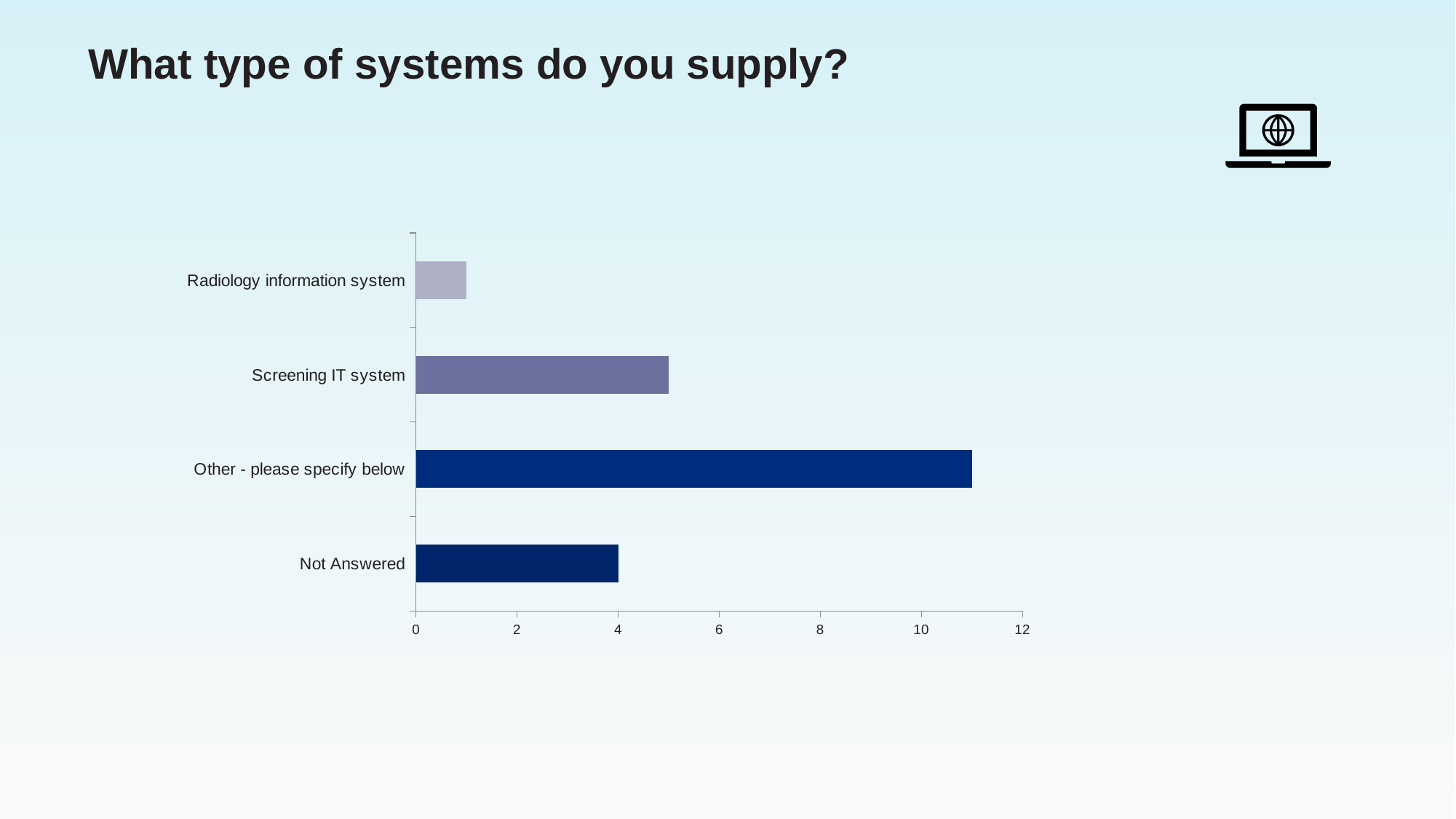
Which is larger, the value for Not Answered or the value for Radiology information system? Not Answered What type of chart is shown on the slide? bar chart Which category has the highest value? Other - please specify below Which is larger, the value for Other - please specify below or the value for Screening IT system? Other - please specify below Is the value for Screening IT system greater or less than 4? greater Which category has the lowest value? Radiology information system What is the value for Not Answered? 4 Is the value for Screening IT system greater or less than 6? less Is the value for Radiology information system greater or less than 2? less How many categories are shown in the chart? 4 What is the title of the slide containing the chart? What type of systems do you supply?